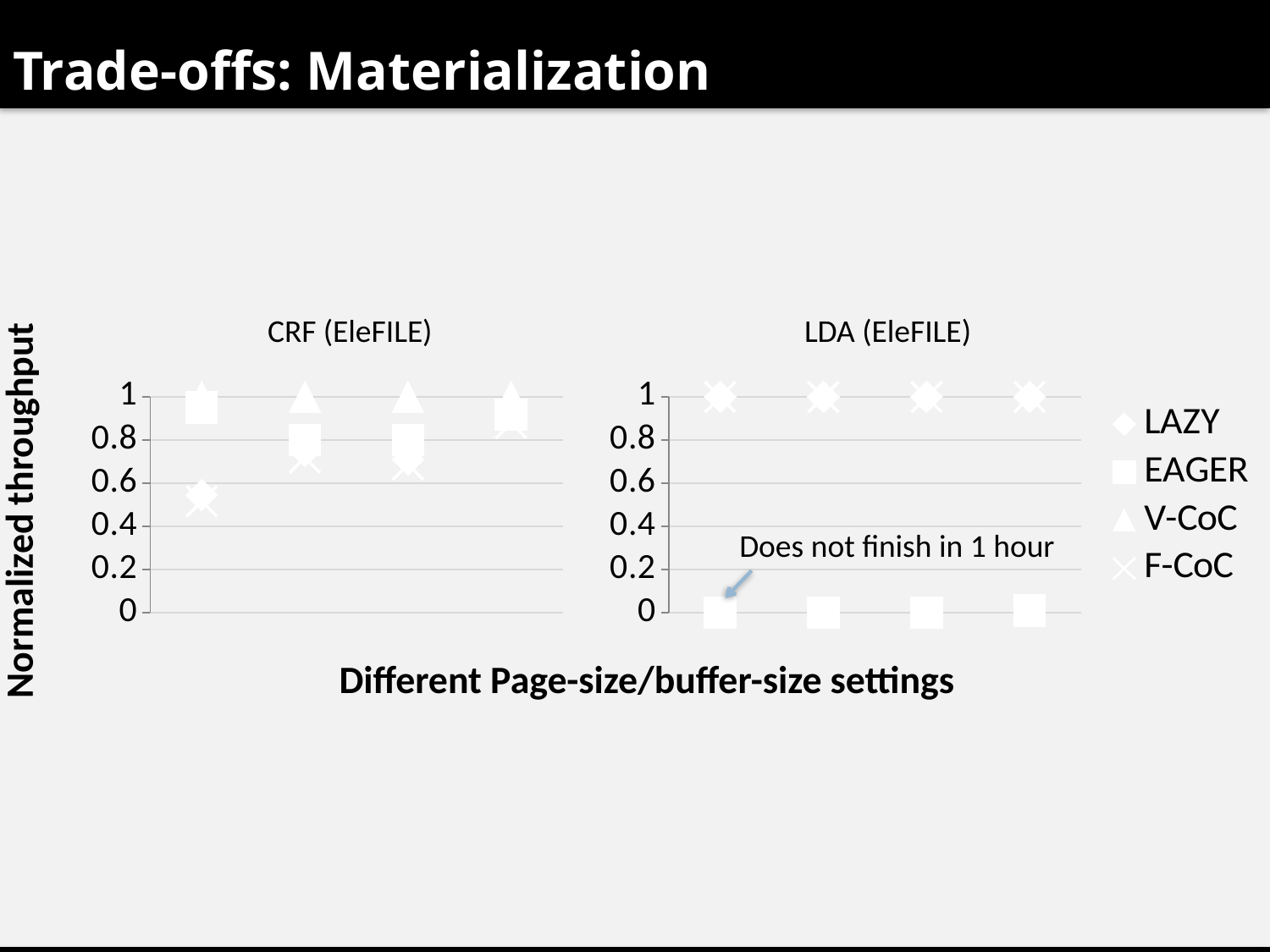
What is the title of the chart on the right? LDA (EleFILE) In the CRF (EleFILE) chart, is the value for LAZY at the first setting greater or less than 0.8? less How many series does the legend list? 4 In the CRF (EleFILE) chart at the first setting, which is larger, the value for EAGER or the value for LAZY? EAGER In the LDA (EleFILE) chart, what normalized throughput value do the F-CoC points have? 1 In the LDA (EleFILE) chart, what normalized throughput value do the EAGER points have? 0 In the CRF (EleFILE) chart, is the value for EAGER at the first setting greater or less than 0.8? greater In the LDA (EleFILE) chart, how many page-size/buffer-size settings are plotted along the x axis? 4 Which series in the legend is shown with a triangle marker? V-CoC What kind of chart is the CRF (EleFILE) chart? scatter chart